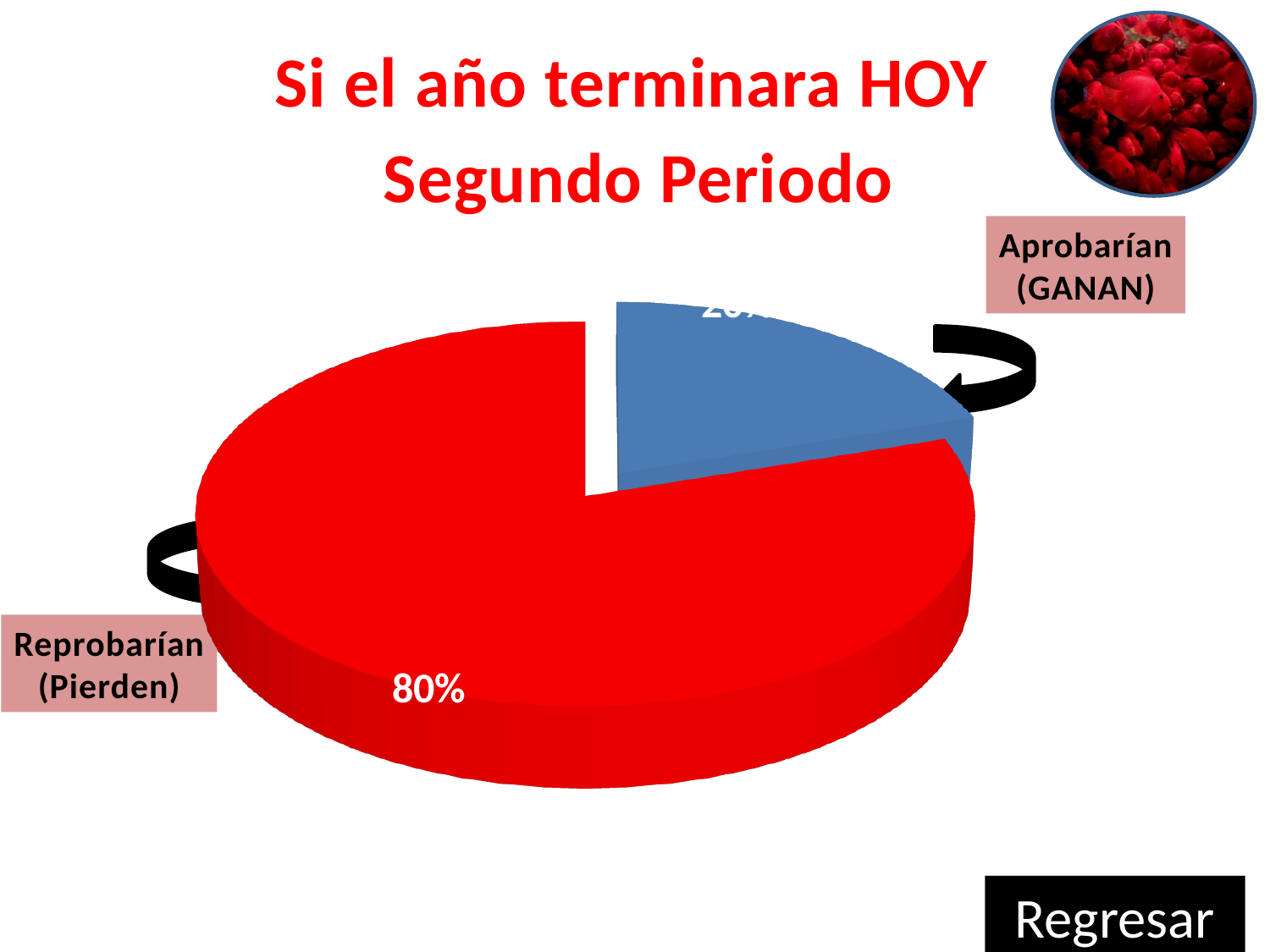
What kind of chart is shown on the slide? pie chart What is the title shown above the pie chart? Si el año terminara HOY Segundo Periodo Is the share for Aprobarían (GANAN) greater or less than 50%? less Which slice of the pie chart is the smallest? Aprobarían (GANAN) Which slice of the pie chart is the largest? Reprobarían (Pierden) What share of the pie does the Reprobarían (Pierden) slice represent? 80% Which is larger, the Reprobarían (Pierden) slice or the Aprobarían (GANAN) slice? Reprobarían (Pierden) Is the share for Reprobarían (Pierden) greater or less than 50%? greater What percentage is shown for the Reprobarían (Pierden) slice? 80% What colour is the Reprobarían (Pierden) slice? red How many slices does the pie chart have? 2